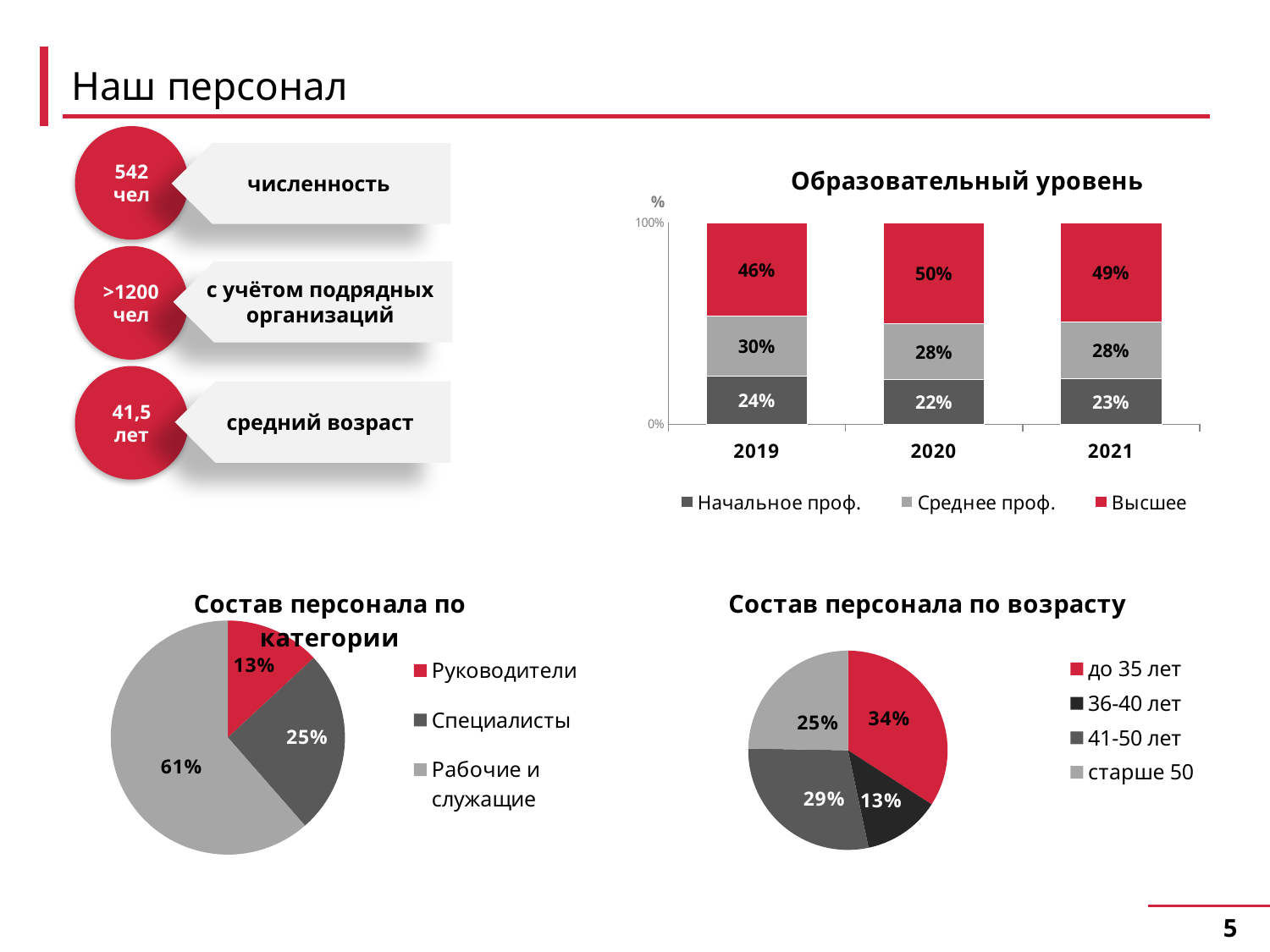
In the pie chart "Состав персонала по категории", what share do Рабочие и служащие have? 61% In the chart "Образовательный уровень", how many years are shown on the x axis? 3 In the pie chart "Состав персонала по возрасту", how many age groups does the legend list? 4 In the chart "Образовательный уровень", how many series does the legend list? 3 What kind of chart is "Образовательный уровень"? Stacked bar chart In the pie chart "Состав персонала по категории", which category has the smallest share? Руководители In the chart "Образовательный уровень", what is the difference between Высшее and Начальное проф. in 2021? 26% In the chart "Образовательный уровень", what is the value for Среднее проф. in 2021? 28% In the chart "Образовательный уровень", what is the value for Высшее in 2020? 50% In the pie chart "Состав персонала по возрасту", what share does the group до 35 лет have? 34% In the chart "Образовательный уровень", what is the value for Начальное проф. in 2019? 24% In the pie chart "Состав персонала по возрасту", which is larger: 41-50 лет or старше 50? 41-50 лет